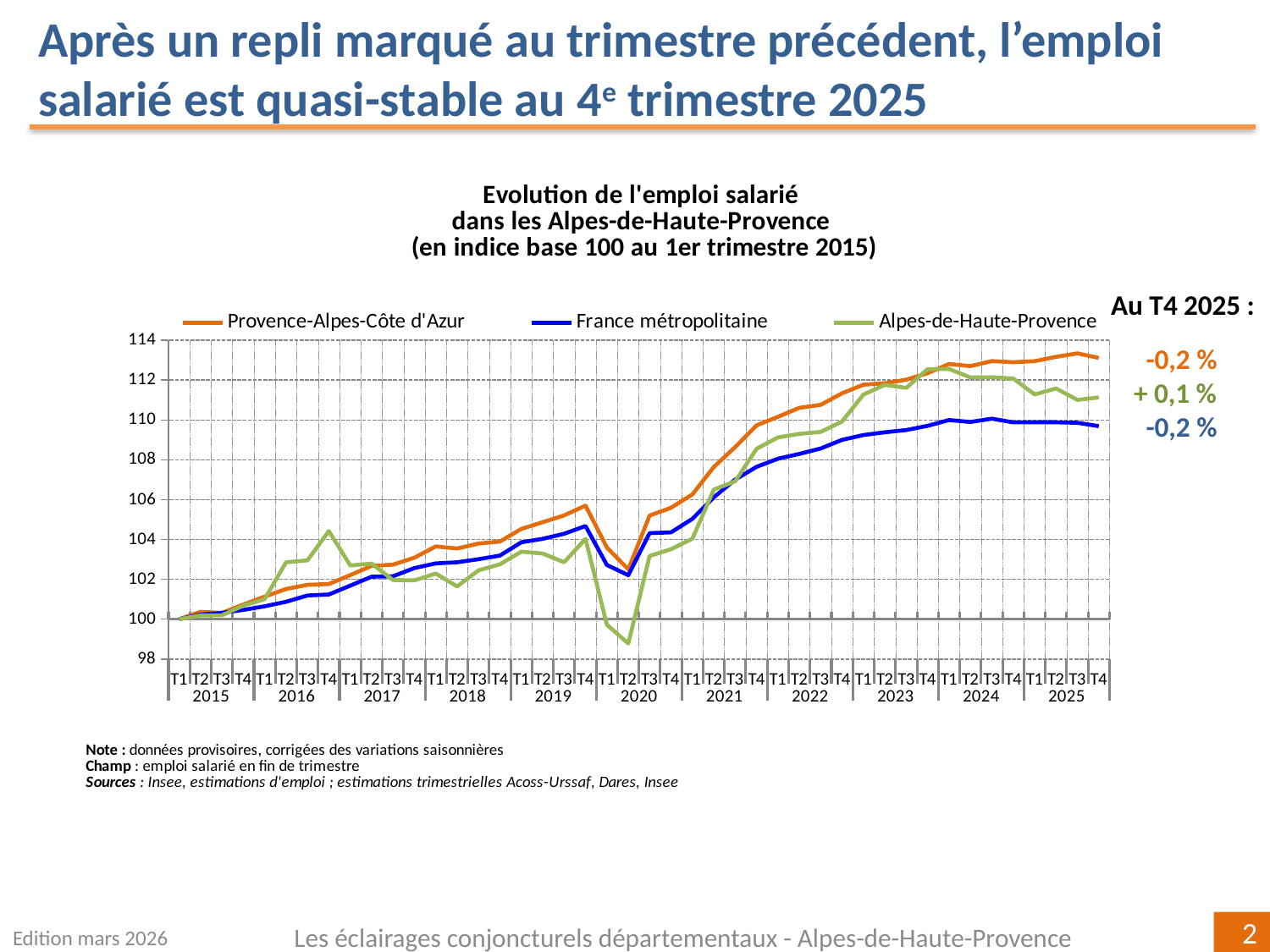
How many series does the legend list? 3 Is the value for Provence-Alpes-Côte d'Azur at T4 2025 greater or less than 112? greater Which series has the lowest index value at T2 2020? Alpes-de-Haute-Provence What is the quarterly change shown for Provence-Alpes-Côte d'Azur at T4 2025? -0,2 % Overall, do the index values rise or fall from 2015 to 2025? rise At T4 2025, which is higher: Provence-Alpes-Côte d'Azur or France métropolitaine? Provence-Alpes-Côte d'Azur What kind of chart is shown on the slide? line chart What is the quarterly change shown for Alpes-de-Haute-Provence at T4 2025? + 0,1 % What is the quarterly change shown for France métropolitaine at T4 2025? -0,2 % Is the value for Alpes-de-Haute-Provence at T2 2020 greater or less than 100? less Which series are listed in the legend? Provence-Alpes-Côte d'Azur, France métropolitaine, Alpes-de-Haute-Provence Which series has the highest index value at T4 2025? Provence-Alpes-Côte d'Azur